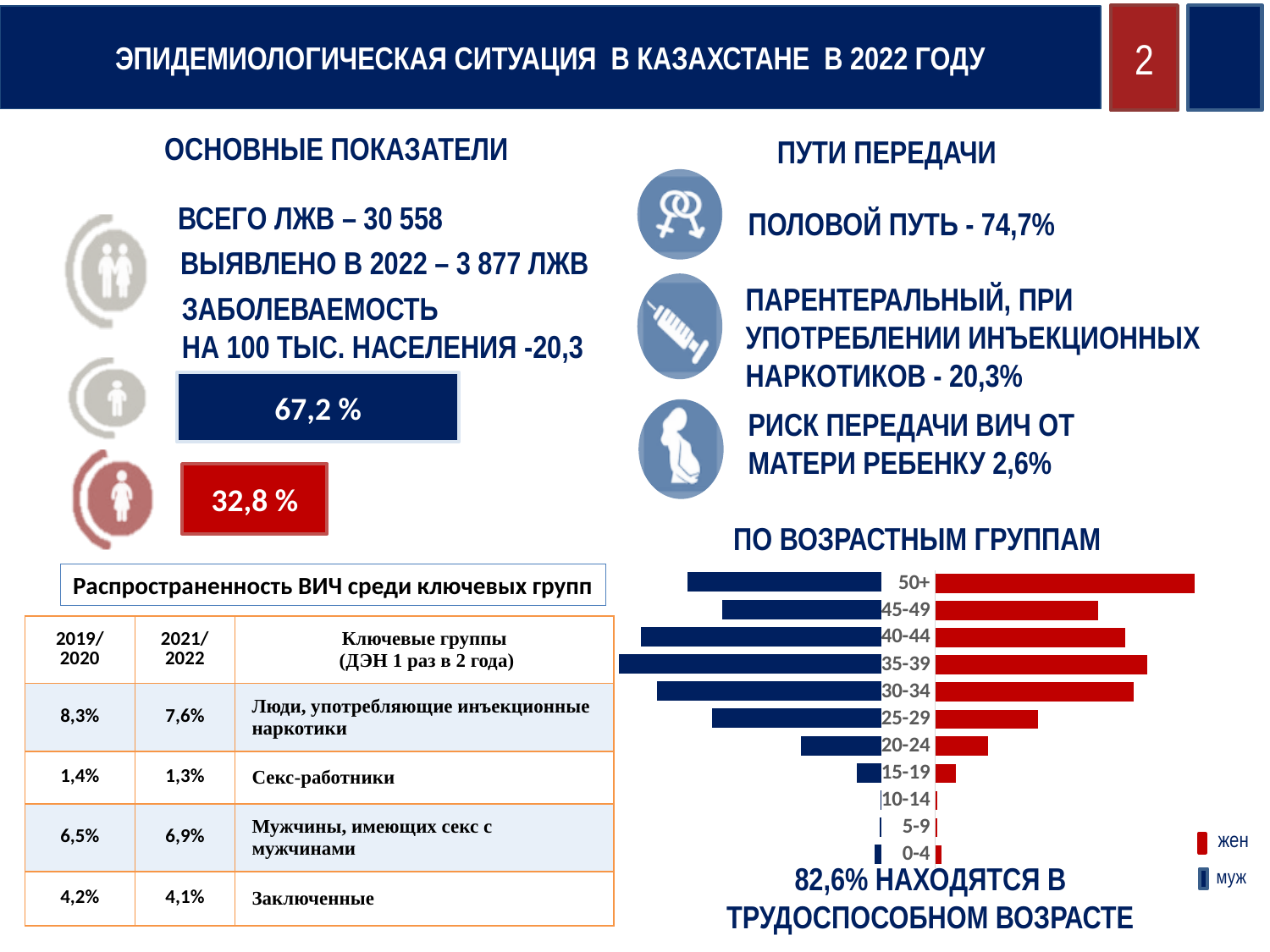
In the "ПО ВОЗРАСТНЫМ ГРУППАМ" chart, which is larger for муж: 15-19 or 10-14? 15-19 How many series does the legend of the "ПО ВОЗРАСТНЫМ ГРУППАМ" chart list? 2 In the "ПО ВОЗРАСТНЫМ ГРУППАМ" chart, which is larger for муж: 35-39 or 25-29? 35-39 In the "ПО ВОЗРАСТНЫМ ГРУППАМ" chart, which age group has the longest bar for муж? 35-39 In the "ПО ВОЗРАСТНЫМ ГРУППАМ" chart, which age group has the longest bar for жен? 50+ What are the two legend entries of the "ПО ВОЗРАСТНЫМ ГРУППАМ" chart? жен, муж In the "ПО ВОЗРАСТНЫМ ГРУППАМ" chart, what colour are the bars for муж? blue In the "ПО ВОЗРАСТНЫМ ГРУППАМ" chart, which is larger for жен: 30-34 or 20-24? 30-34 What kind of chart is shown under the heading "ПО ВОЗРАСТНЫМ ГРУППАМ"? bar chart How many age groups are shown in the "ПО ВОЗРАСТНЫМ ГРУППАМ" chart? 11